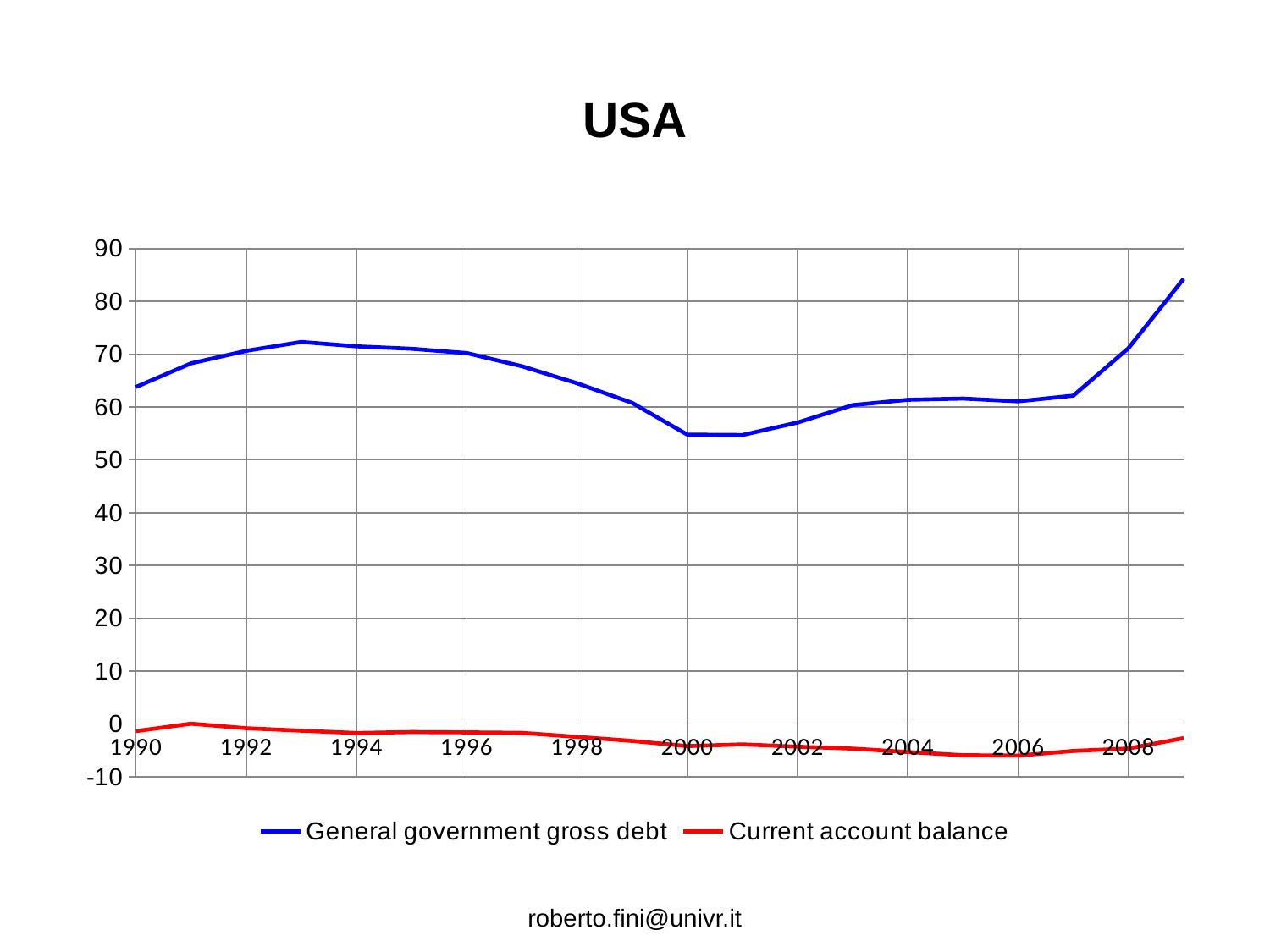
Which colour is used for the Current account balance line? red Which is larger: General government gross debt in 1990 or in 2000? 1990 In which year does General government gross debt reach its highest value? 2009 Does General government gross debt rise or fall between 2001 and 2009? rise Is the value of General government gross debt in 1990 greater or less than 60? greater What kind of chart is shown on the slide? line chart What is the title of the chart? USA Is the value of General government gross debt at the last point (2009) greater or less than 80? greater Is the value of Current account balance in 2006 greater or less than 0? less Does Current account balance rise or fall between 1991 and 2006? fall How many series does the legend list? 2